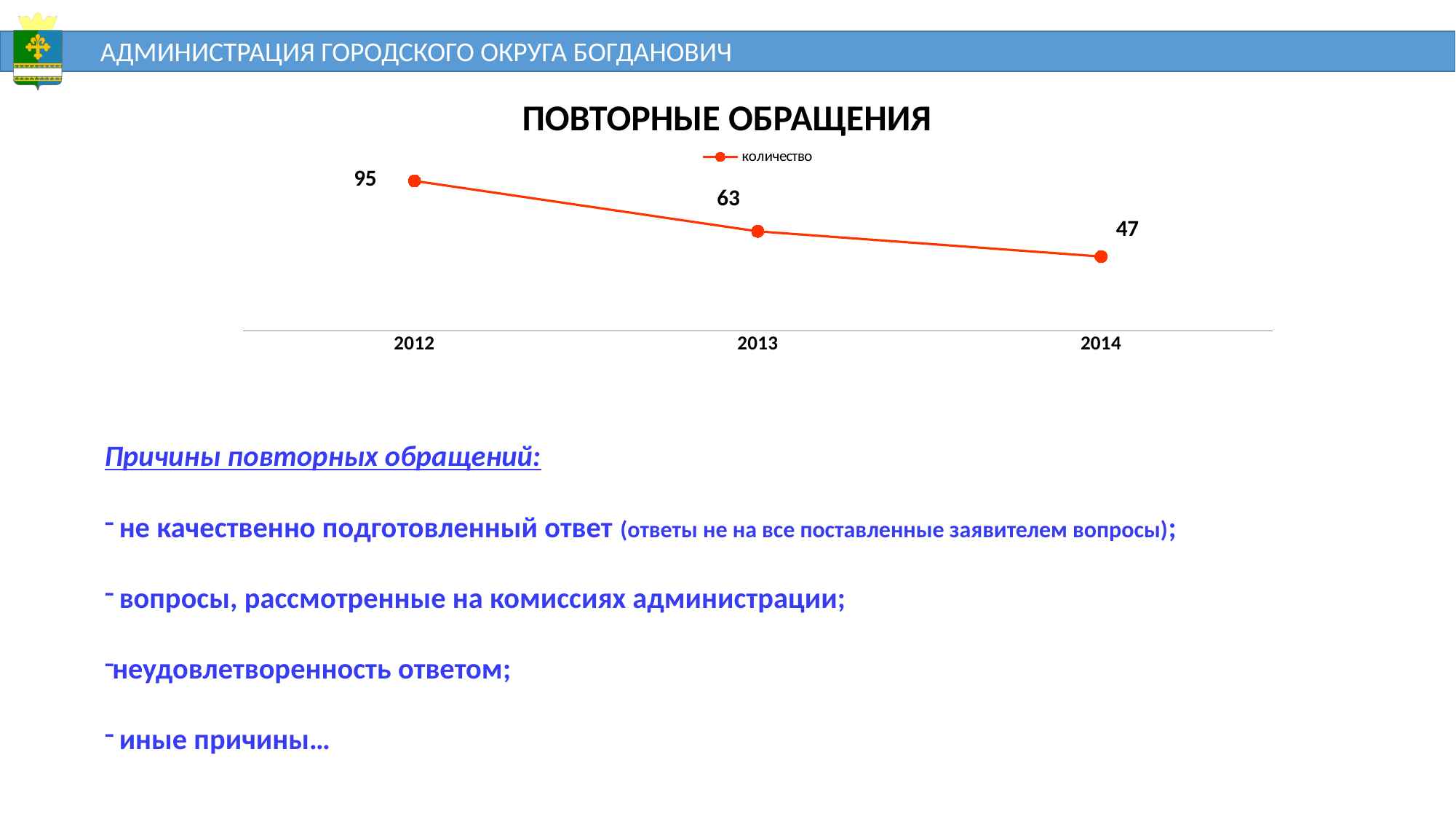
Which year has the highest value? 2012 How many data points are plotted on the chart? 3 How many series does the legend list? 1 What is the value for 2012? 95 What is the value for 2013? 63 What is the difference between the values for 2012 and 2013? 32 Which year has the lowest value? 2014 Which is larger, the value for 2013 or the value for 2014? 2013 What is the value for 2014? 47 Do the values rise or fall from 2012 to 2014? fall What is the difference between the values for 2012 and 2014? 48 What kind of chart is shown on the slide? line chart